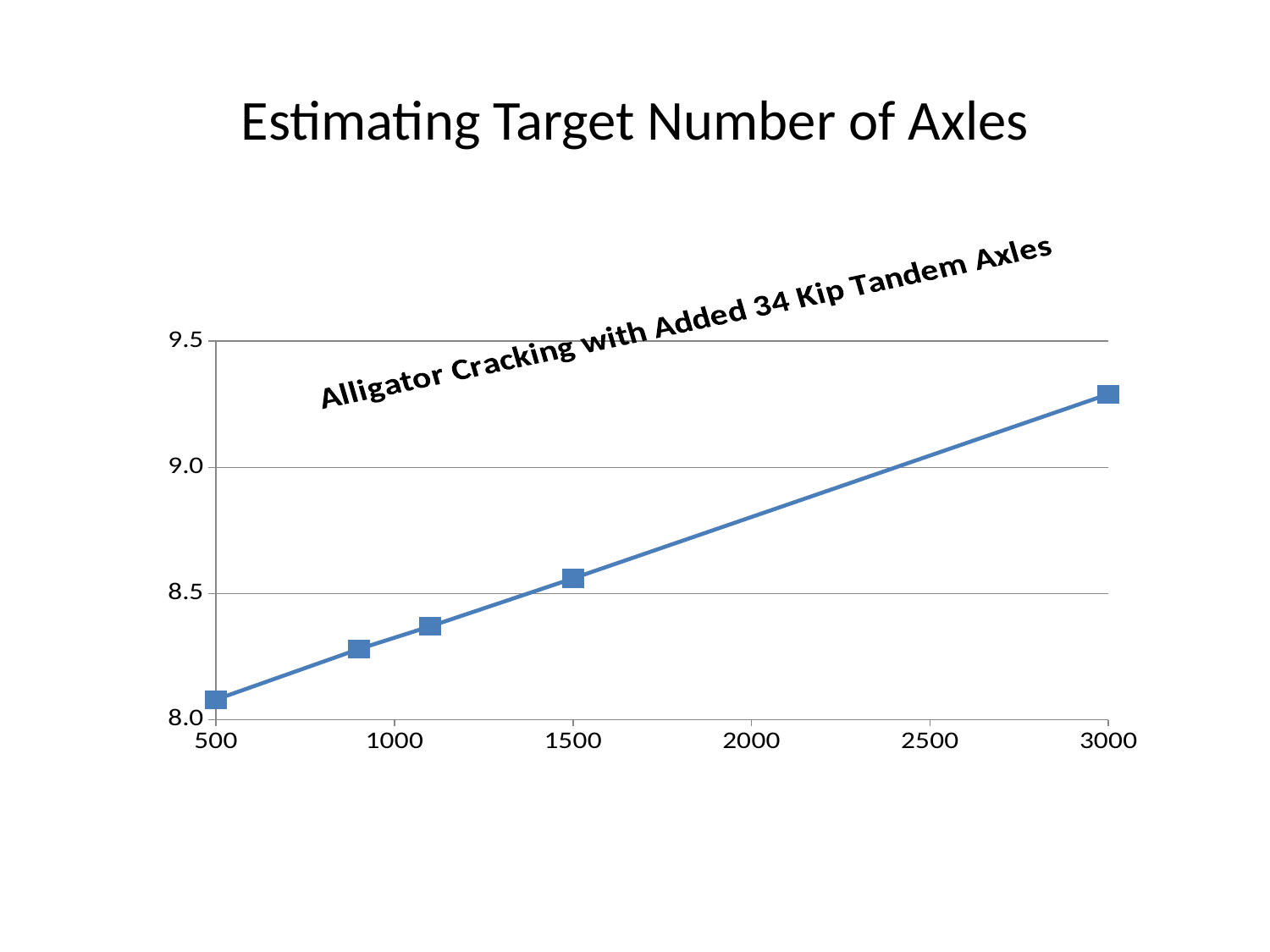
Which has the larger plotted value, x = 1100 or x = 3000? 3000 Is the value at x = 1500 greater or less than 9.0? less Do the plotted values rise or fall as the x-axis value increases from 500 to 3000? rise At which x-axis value is the plotted value lowest? 500 At which x-axis value is the plotted value highest? 3000 How many data points are plotted on the line? 5 What is the title of the chart? Alligator Cracking with Added 34 Kip Tandem Axles Is the value at x = 500 greater or less than 8.5? less What kind of chart is shown on the slide? line chart What is the lowest value shown on the y-axis? 8.0 Is the value at x = 3000 greater or less than 9.0? greater